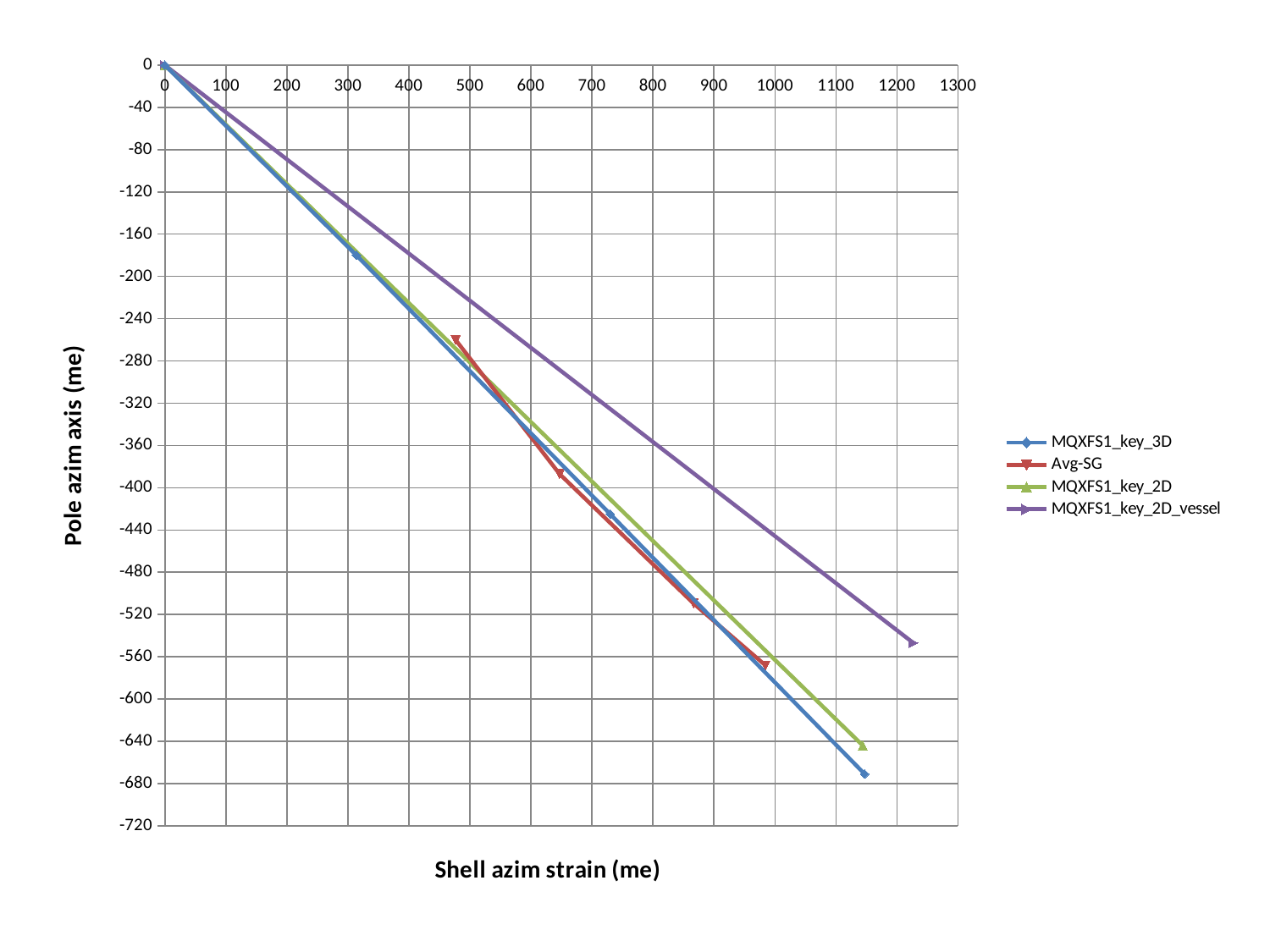
How many series does the legend list? 4 What is the title of the y axis? Pole azim axis (me) Do the Pole azim axis values rise or fall as Shell azim strain increases? fall Is the Shell azim strain of the first point of Avg-SG greater or less than 400? greater Is the Pole azim axis value of the last point of MQXFS1_key_2D_vessel greater or less than -600? greater Is the Pole azim axis value of the last point of MQXFS1_key_3D greater or less than -640? less Which series reaches the lowest (most negative) Pole azim axis value? MQXFS1_key_3D What is the title of the x axis? Shell azim strain (me) At a Shell azim strain of 800, which series has the higher (less negative) Pole azim axis value, MQXFS1_key_2D_vessel or MQXFS1_key_3D? MQXFS1_key_2D_vessel Which series reaches the largest Shell azim strain value? MQXFS1_key_2D_vessel What kind of chart is shown on the slide? line chart